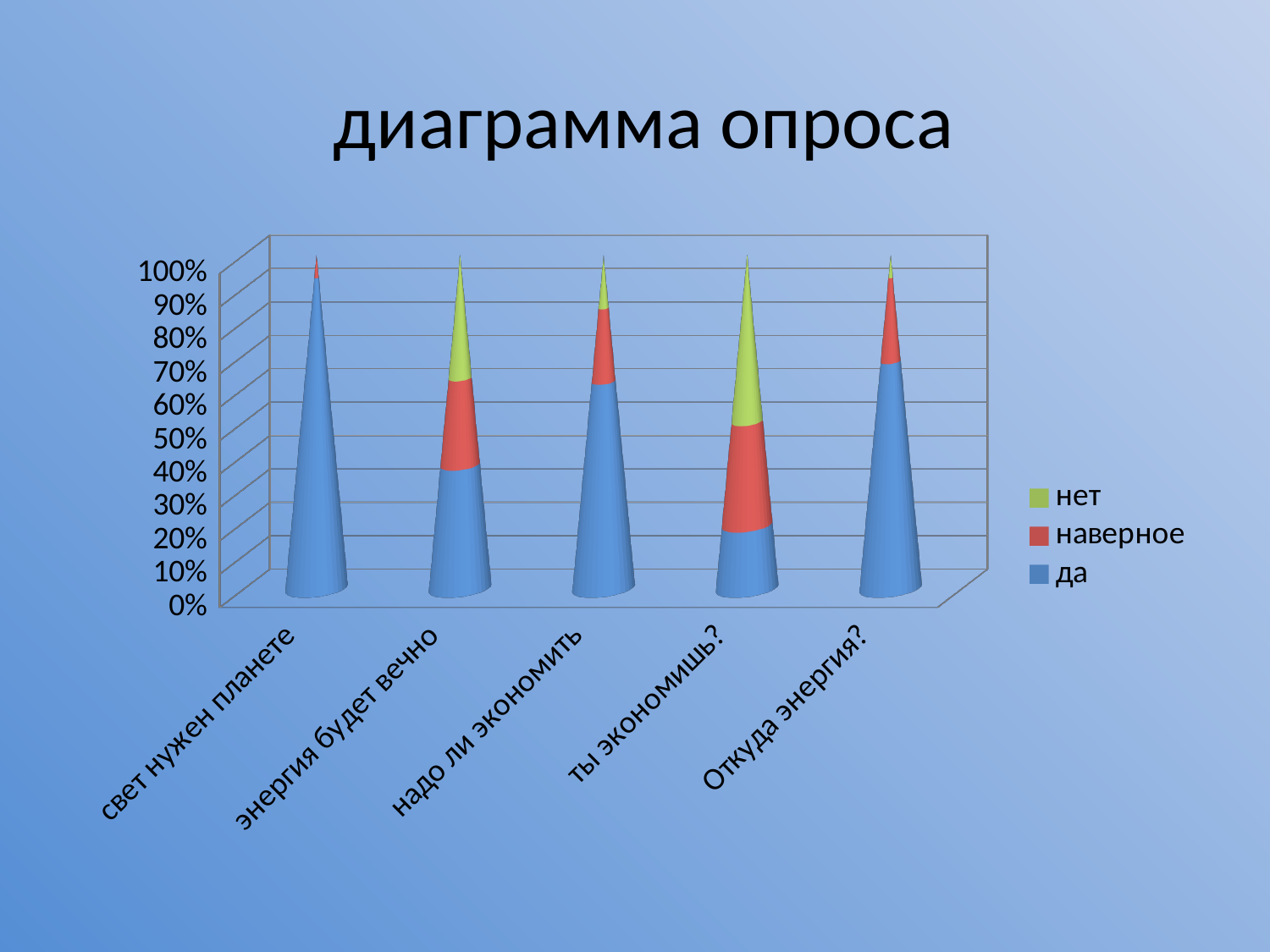
Is the share of "нет" for "ты экономишь?" greater or less than 30%? greater Is the share of "да" for "Откуда энергия?" greater or less than 50%? greater What kind of chart is shown on the slide? bar chart How many series does the legend list? 3 Is the share of "да" for "свет нужен планете" greater or less than 90%? greater Which category has the highest share of "да"? свет нужен планете How many categories are shown on the x axis? 5 Which has the larger share of "да": "свет нужен планете" or "ты экономишь?"? свет нужен планете Which series is shown in blue in the legend? да Which category has the lowest share of "да"? ты экономишь? What is the title of the chart? диаграмма опроса